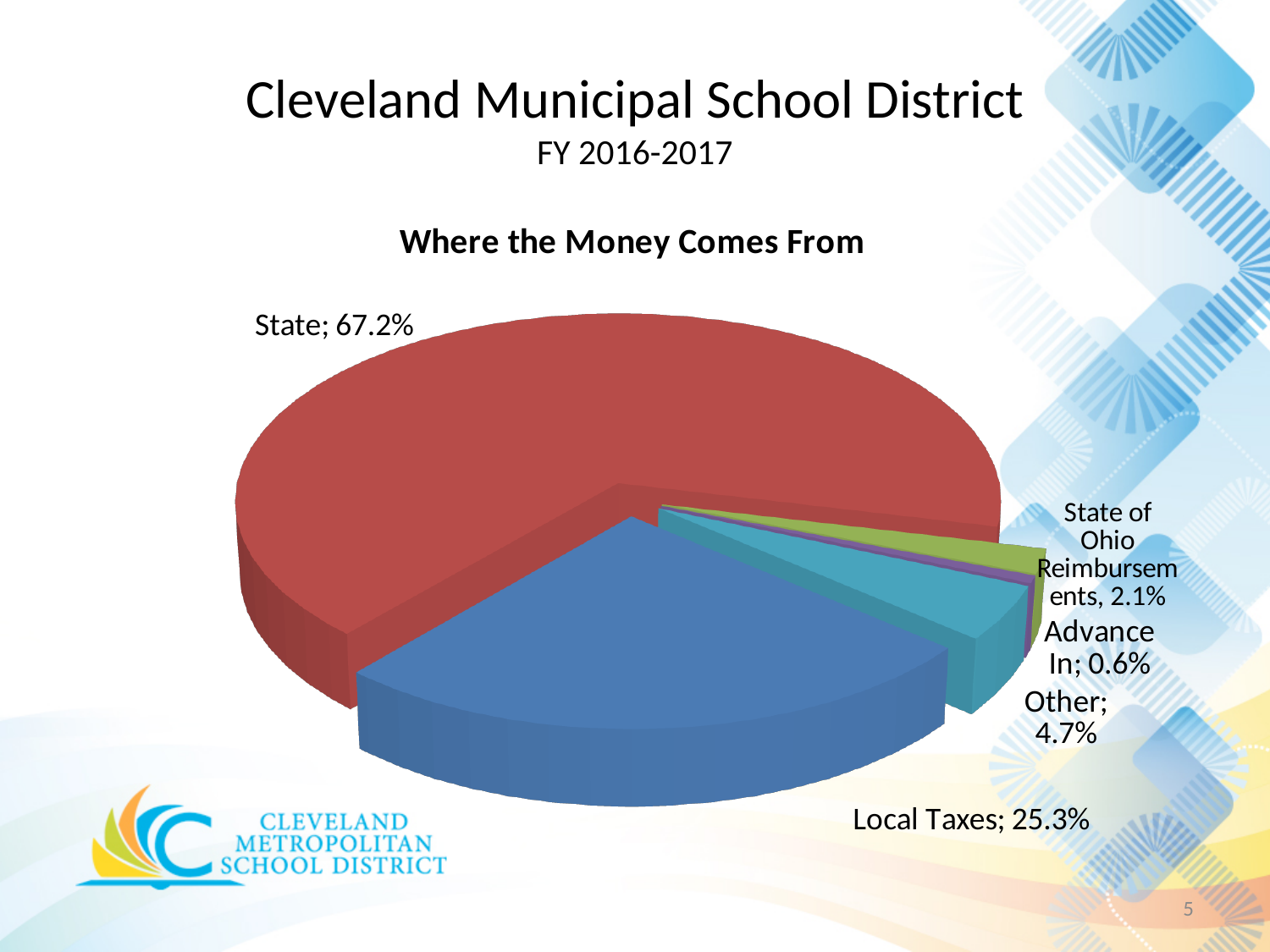
What is the difference in percentage points between the State share and the Local Taxes share? 41.9 Which source provides the smallest share of the money? Advance In What share of the money comes from State of Ohio Reimbursements? 2.1% How many slices does the pie chart have? 5 Which is larger, the share from Other or the share from State of Ohio Reimbursements? Other Which source provides the largest share of the money? State What share of the money comes from the State? 67.2% What kind of chart is shown on the slide? Pie chart What is the title of the chart? Where the Money Comes From What share of the money comes from Other? 4.7% What share of the money comes from Advance In? 0.6% What share of the money comes from Local Taxes? 25.3%